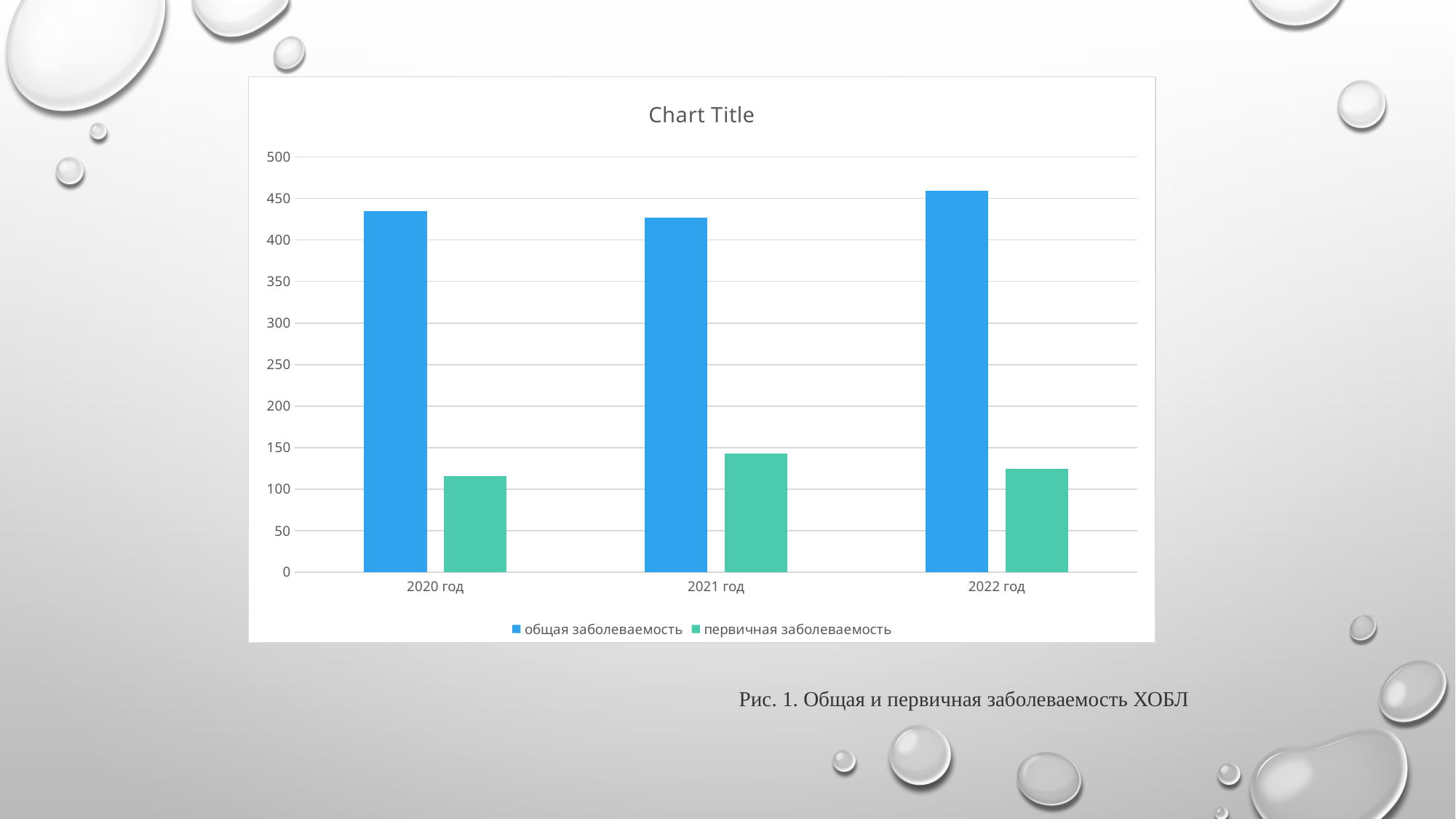
In which year is общая заболеваемость highest? 2022 год Is the value for общая заболеваемость in 2020 год greater or less than 400? greater What colour are the bars for общая заболеваемость? blue Which is larger: общая заболеваемость in 2022 год or in 2020 год? 2022 год How many series does the legend list? 2 Is the value for первичная заболеваемость in 2021 год greater or less than 150? less How many year categories are shown on the x axis? 3 In which year is первичная заболеваемость highest? 2021 год Is the value for общая заболеваемость in 2022 год greater or less than 450? greater Does первичная заболеваемость rise or fall from 2020 год to 2021 год? rise What kind of chart is shown on the slide? bar chart